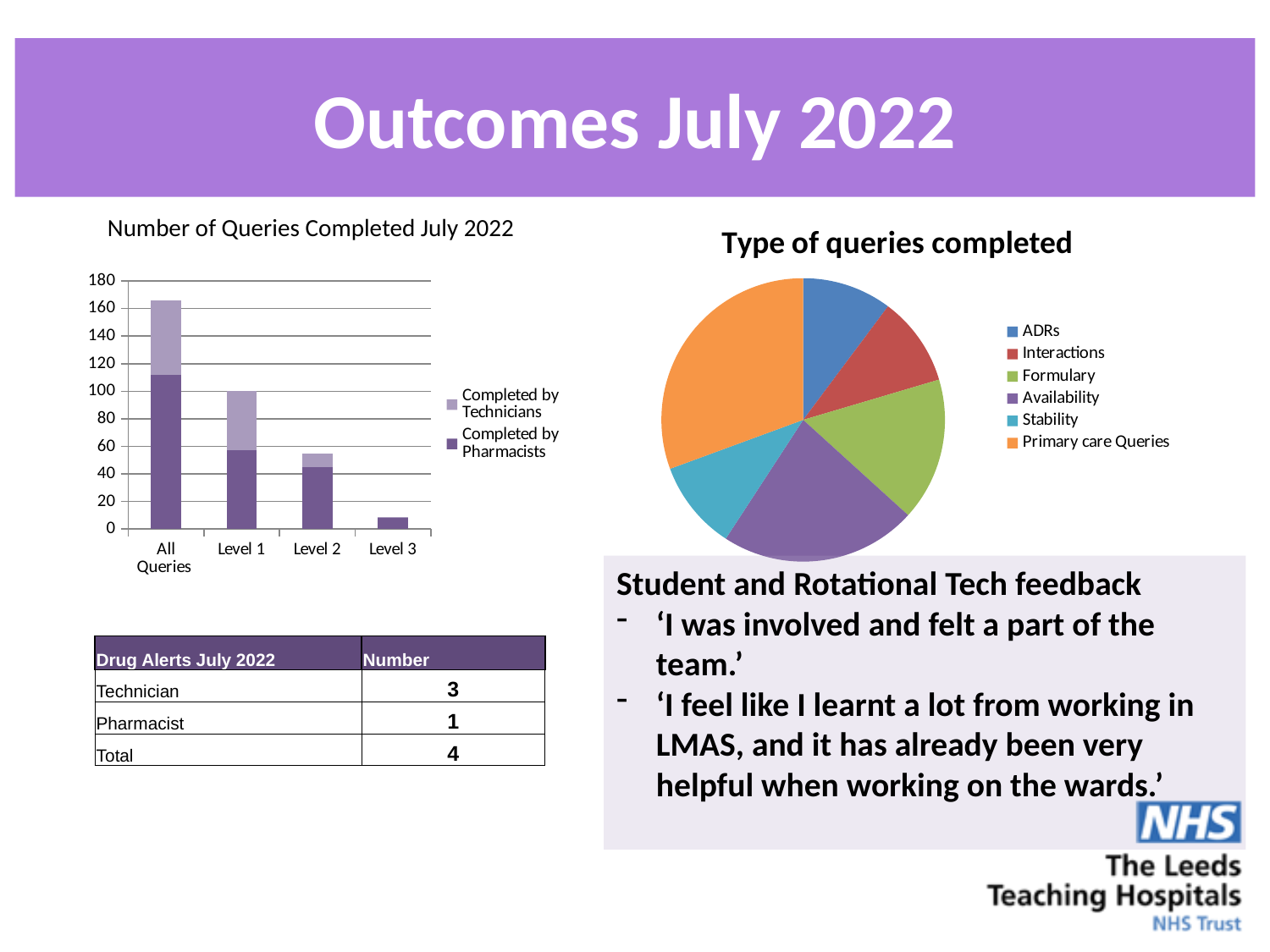
In the 'Number of Queries Completed July 2022' chart, do the total stacked bar values rise or fall from All Queries to Level 3? fall In the 'Number of Queries Completed July 2022' chart, which series is shown in the lighter purple colour? Completed by Technicians In the 'Type of queries completed' pie chart, which category has the largest slice? Primary care Queries In the 'Number of Queries Completed July 2022' chart, is the total stacked value for All Queries greater or less than 140? greater In the 'Number of Queries Completed July 2022' chart, is the total stacked value for Level 3 greater or less than 20? less In the 'Type of queries completed' pie chart, how many slices are there? 6 In the 'Number of Queries Completed July 2022' chart, how many series does the legend list? 2 In the 'Number of Queries Completed July 2022' chart, how many categories are shown on the x axis? 4 In the 'Number of Queries Completed July 2022' chart, is the value for Completed by Pharmacists at Level 1 greater or less than 80? less In the 'Number of Queries Completed July 2022' chart, which has the larger total stacked bar, Level 1 or Level 2? Level 1 What kind of chart is the 'Type of queries completed' chart? pie chart What kind of chart is the 'Number of Queries Completed July 2022' chart? bar chart